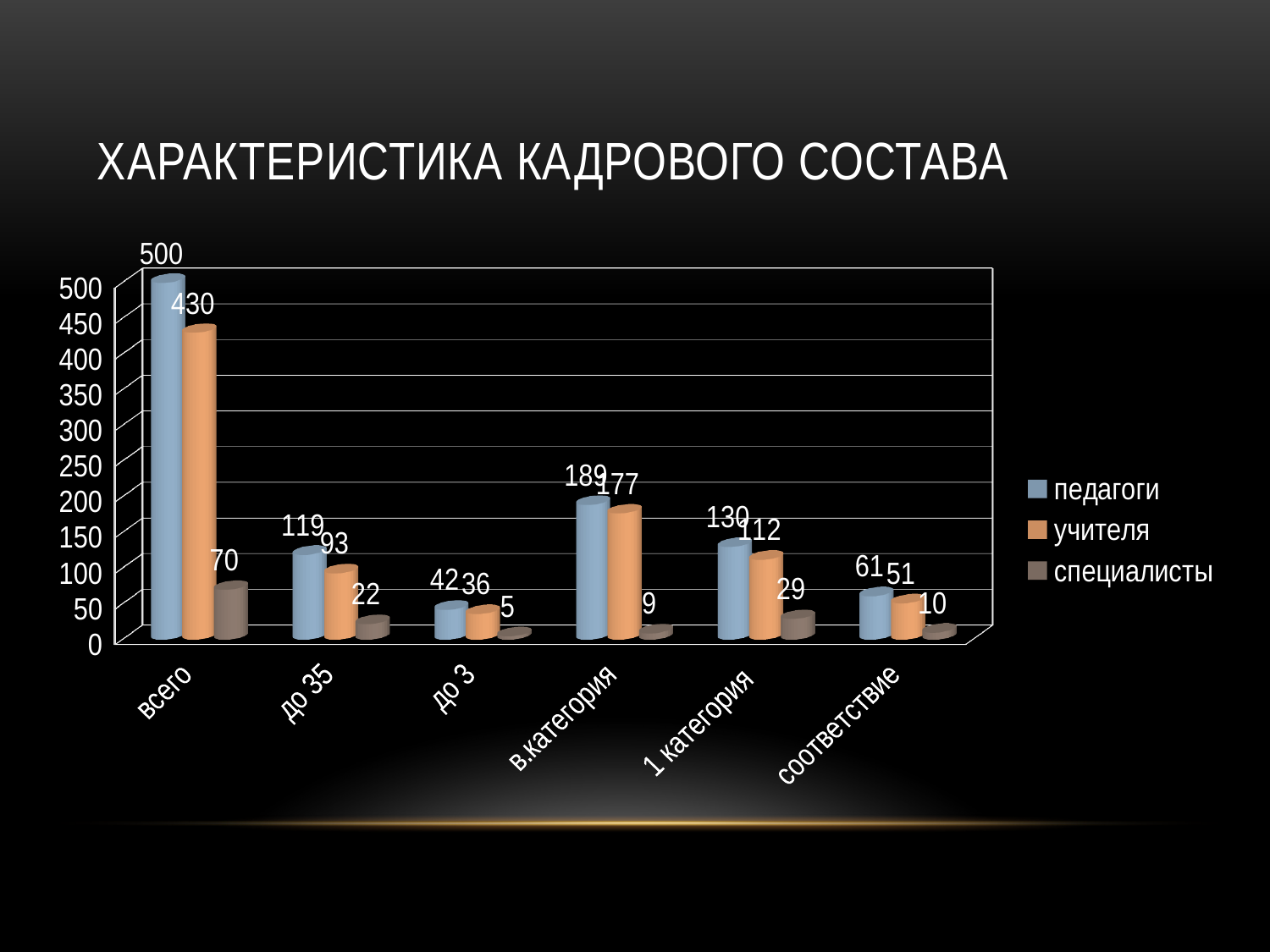
How many categories are shown on the x axis? 6 Which category has the lowest value for специалисты? до 3 What is the value for педагоги in the всего category? 500 What is the value for специалисты in the 1 категория category? 29 Which category has the highest value for учителя? всего Which is larger: педагоги in в.категория or педагоги in 1 категория? педагоги in в.категория What is the title of the slide? ХАРАКТЕРИСТИКА КАДРОВОГО СОСТАВА How many series does the legend list? 3 What is the value for учителя in the в.категория category? 177 What kind of chart is shown on the slide? bar chart What is the value for учителя in the до 35 category? 93 What is the difference between педагоги and учителя in the всего category? 70